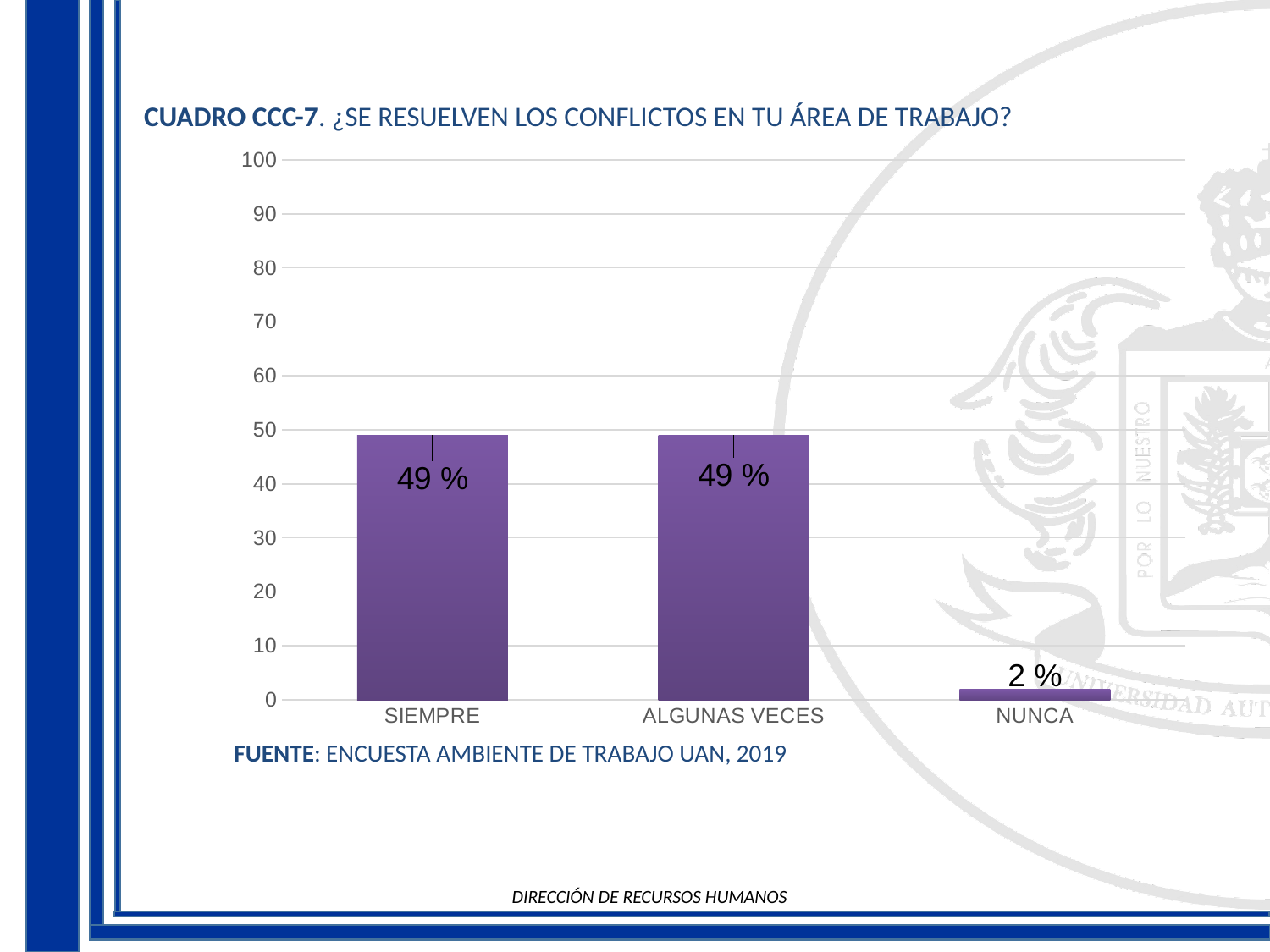
What source is cited below the chart? ENCUESTA AMBIENTE DE TRABAJO UAN, 2019 Is the value for SIEMPRE greater or less than 40? greater What is the value for ALGUNAS VECES? 49 % Is the value for NUNCA greater or less than 10? less What is the highest value shown on the y axis? 100 What kind of chart is shown on the slide? bar chart Which is larger, the value for ALGUNAS VECES or the value for NUNCA? ALGUNAS VECES Which category has the lowest value? NUNCA What is the value for SIEMPRE? 49 % What is the value for NUNCA? 2 % How many categories are shown on the x axis? 3 What is the difference between the values for SIEMPRE and NUNCA? 47 %